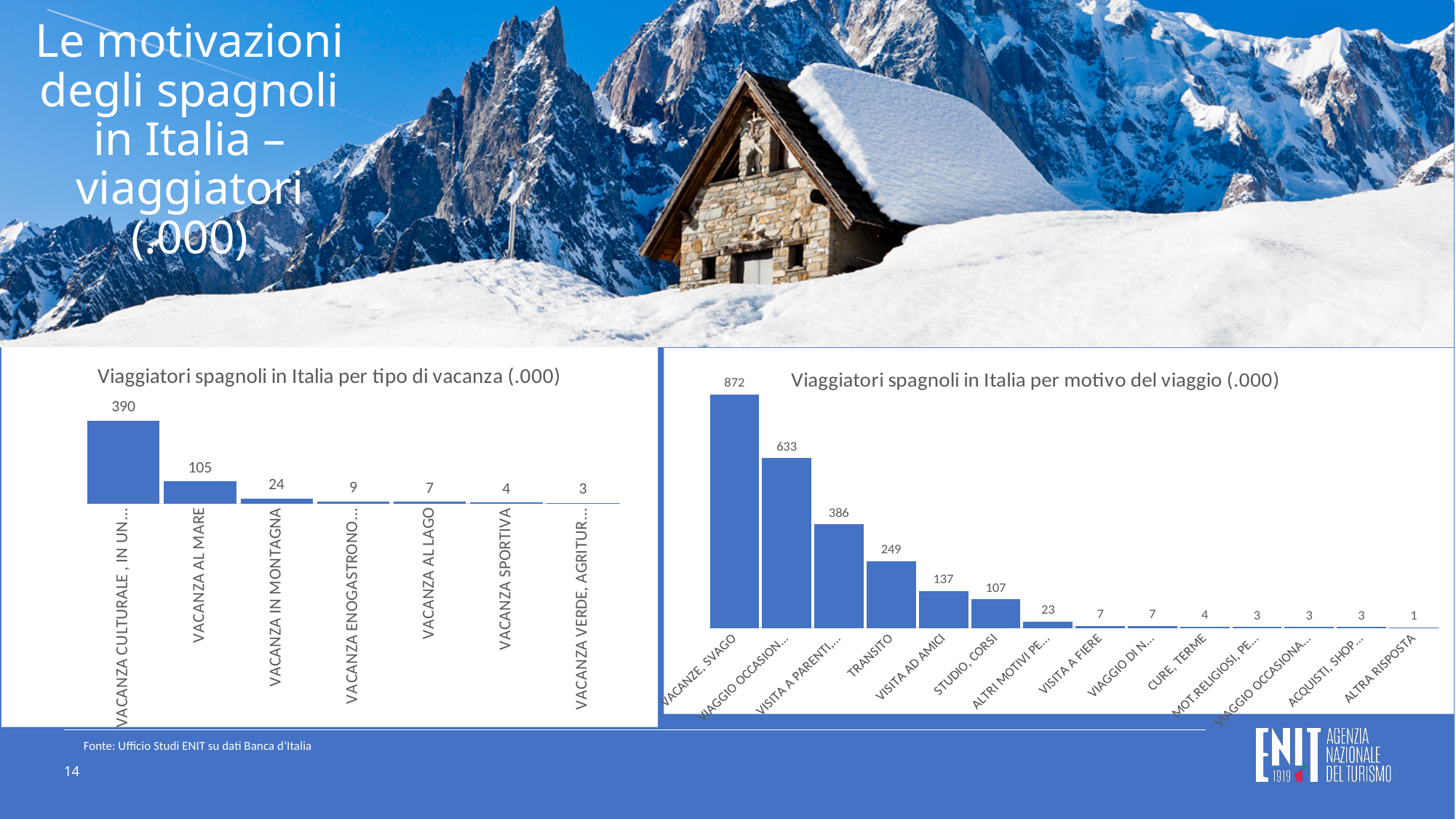
In the chart 'Viaggiatori spagnoli in Italia per motivo del viaggio (.000)', what is the value for TRANSITO? 249 How many bars are shown in the chart 'Viaggiatori spagnoli in Italia per motivo del viaggio (.000)'? 14 In the chart 'Viaggiatori spagnoli in Italia per motivo del viaggio (.000)', what is the value for STUDIO, CORSI? 107 In the chart 'Viaggiatori spagnoli in Italia per tipo di vacanza (.000)', what is the value for VACANZA AL MARE? 105 In the chart 'Viaggiatori spagnoli in Italia per motivo del viaggio (.000)', what is the difference between the values for VACANZE, SVAGO and TRANSITO? 623 How many bars are shown in the chart 'Viaggiatori spagnoli in Italia per tipo di vacanza (.000)'? 7 What type of chart is 'Viaggiatori spagnoli in Italia per motivo del viaggio (.000)'? Bar chart In the chart 'Viaggiatori spagnoli in Italia per motivo del viaggio (.000)', which is larger: VISITA AD AMICI or STUDIO, CORSI? VISITA AD AMICI In the chart 'Viaggiatori spagnoli in Italia per tipo di vacanza (.000)', what is the difference between the values for VACANZA AL MARE and VACANZA IN MONTAGNA? 81 In the chart 'Viaggiatori spagnoli in Italia per tipo di vacanza (.000)', what is the value for VACANZA IN MONTAGNA? 24 In the chart 'Viaggiatori spagnoli in Italia per motivo del viaggio (.000)', which category has the highest value? VACANZE, SVAGO In the chart 'Viaggiatori spagnoli in Italia per tipo di vacanza (.000)', which category has the lowest value? VACANZA VERDE, AGRITUR...